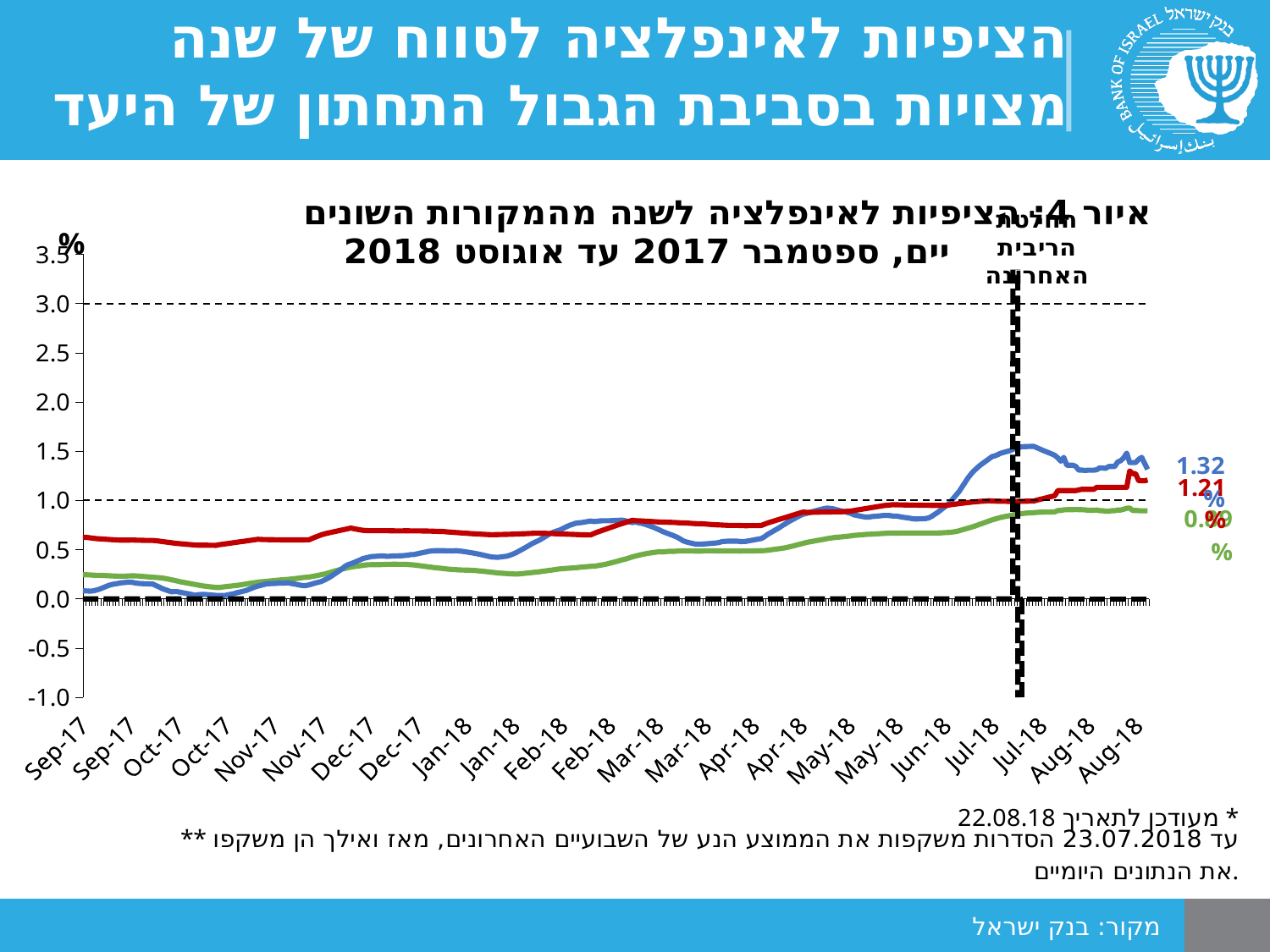
Which line has the lowest value at the right end of the chart (August 2018)? the green line Is the value of the blue line at the start of the chart (Sep-17) greater or less than 0.5? less At what two y-axis levels are the horizontal dashed lines drawn on the chart? 1.0 and 3.0 Which line has the highest value at the right end of the chart (August 2018)? the blue line What is the difference between the final labelled values of the blue line (1.32) and the red line (1.21)? 0.11 What is the final value labelled for the red line at the right end of the chart? 1.21 What is the final value labelled for the blue line at the right end of the chart? 1.32 At the right end of the chart, is the blue line's value greater or less than the red line's value? greater Is the value of the green line at the right end of the chart greater or less than 1.0? less What type of chart is shown on the slide? line chart Does the blue line overall rise or fall from Sep-17 to Aug-18? rise